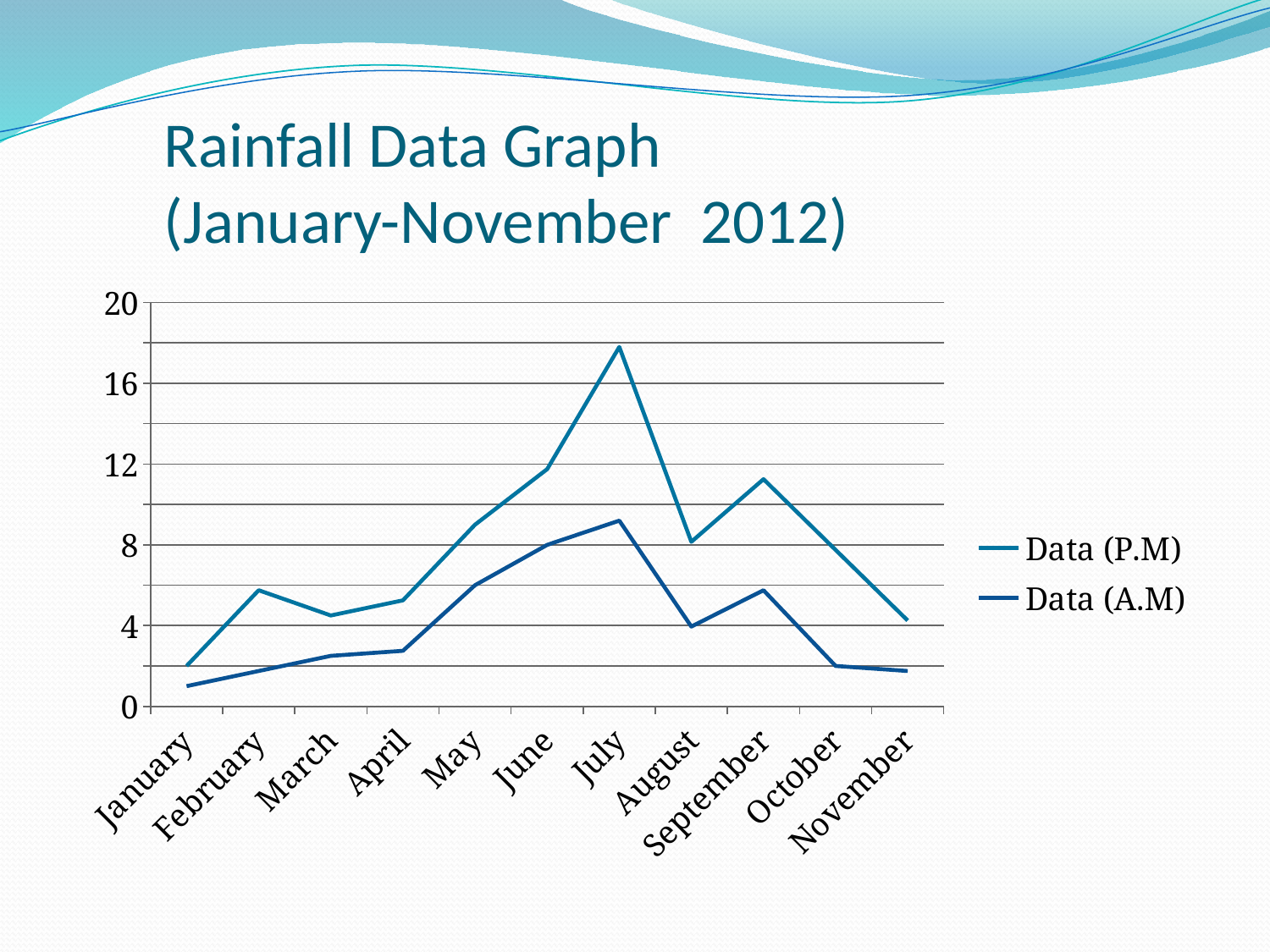
In which month does the Data (P.M) series reach its highest value? July In July, which series has the larger value, Data (P.M) or Data (A.M)? Data (P.M) What are the two series names shown in the legend? Data (P.M) and Data (A.M) How many months are plotted along the x axis? 11 What kind of chart is shown on the slide? line chart Is the Data (A.M) value for July greater or less than 8? greater How many series does the legend list? 2 Is the Data (P.M) value for July greater or less than 16? greater In which month is the Data (P.M) series at its lowest value? January Does the Data (P.M) series rise or fall from April to July? rise In which month does the Data (A.M) series reach its highest value? July Is the Data (A.M) value for January greater or less than 4? less